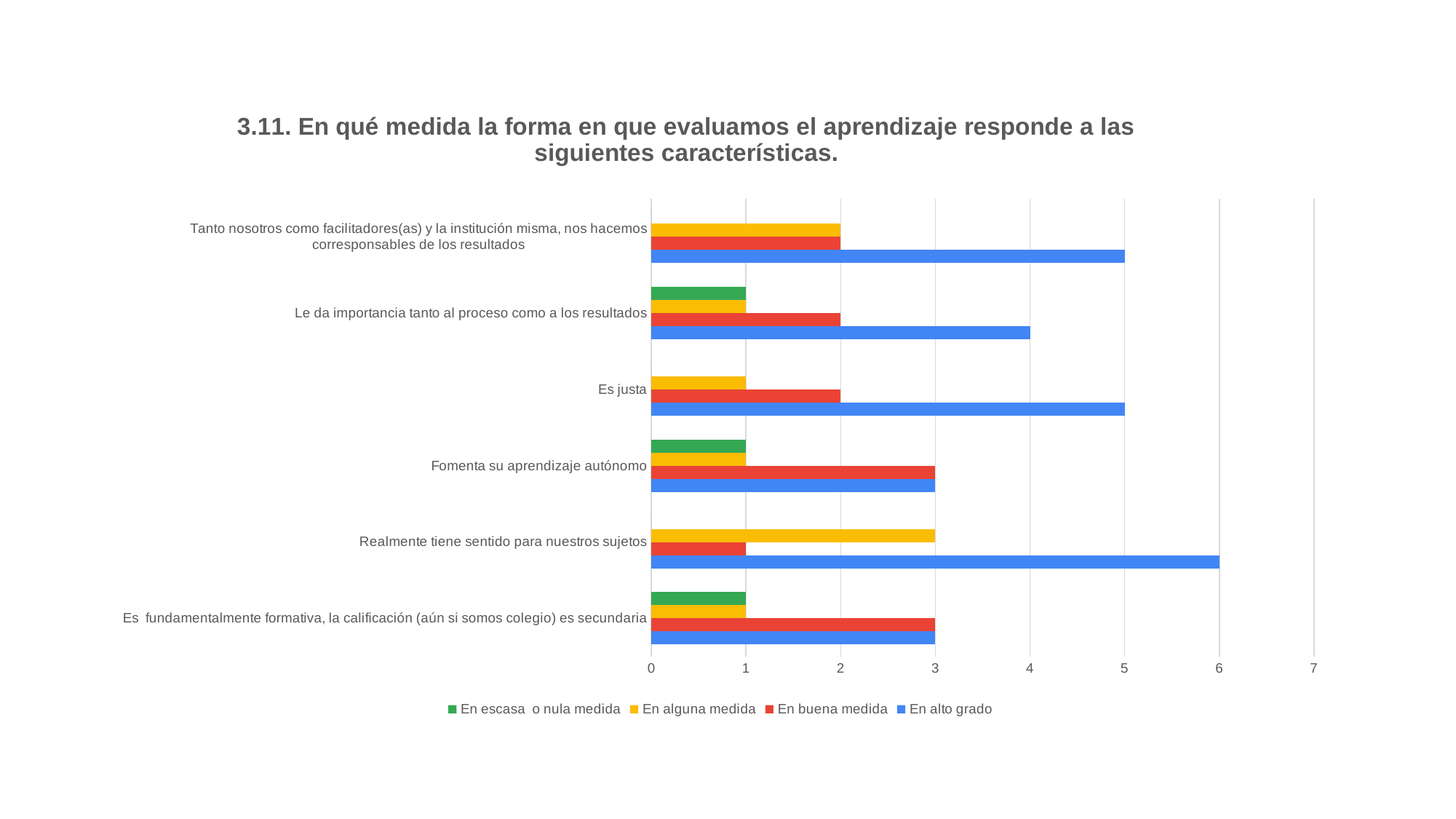
How many series does the legend list? 4 How many categories are shown on the chart? 6 Which category has the lowest value for "En buena medida"? Realmente tiene sentido para nuestros sujetos What colour represents the "En alto grado" series? Blue What is the difference between the "En alto grado" values for "Es justa" and "Fomenta su aprendizaje autónomo"? 2 What is the value of "En alguna medida" for "Realmente tiene sentido para nuestros sujetos"? 3 Which category has the highest value for "En alto grado"? Realmente tiene sentido para nuestros sujetos What is the value of "En alto grado" for "Le da importancia tanto al proceso como a los resultados"? 4 What is the value of "En buena medida" for "Es justa"? 2 What is the value of "En alto grado" for "Realmente tiene sentido para nuestros sujetos"? 6 Which is larger for "Tanto nosotros como facilitadores(as) y la institución misma, nos hacemos corresponsables de los resultados": "En alto grado" or "En buena medida"? En alto grado What kind of chart is shown on the slide? Bar chart